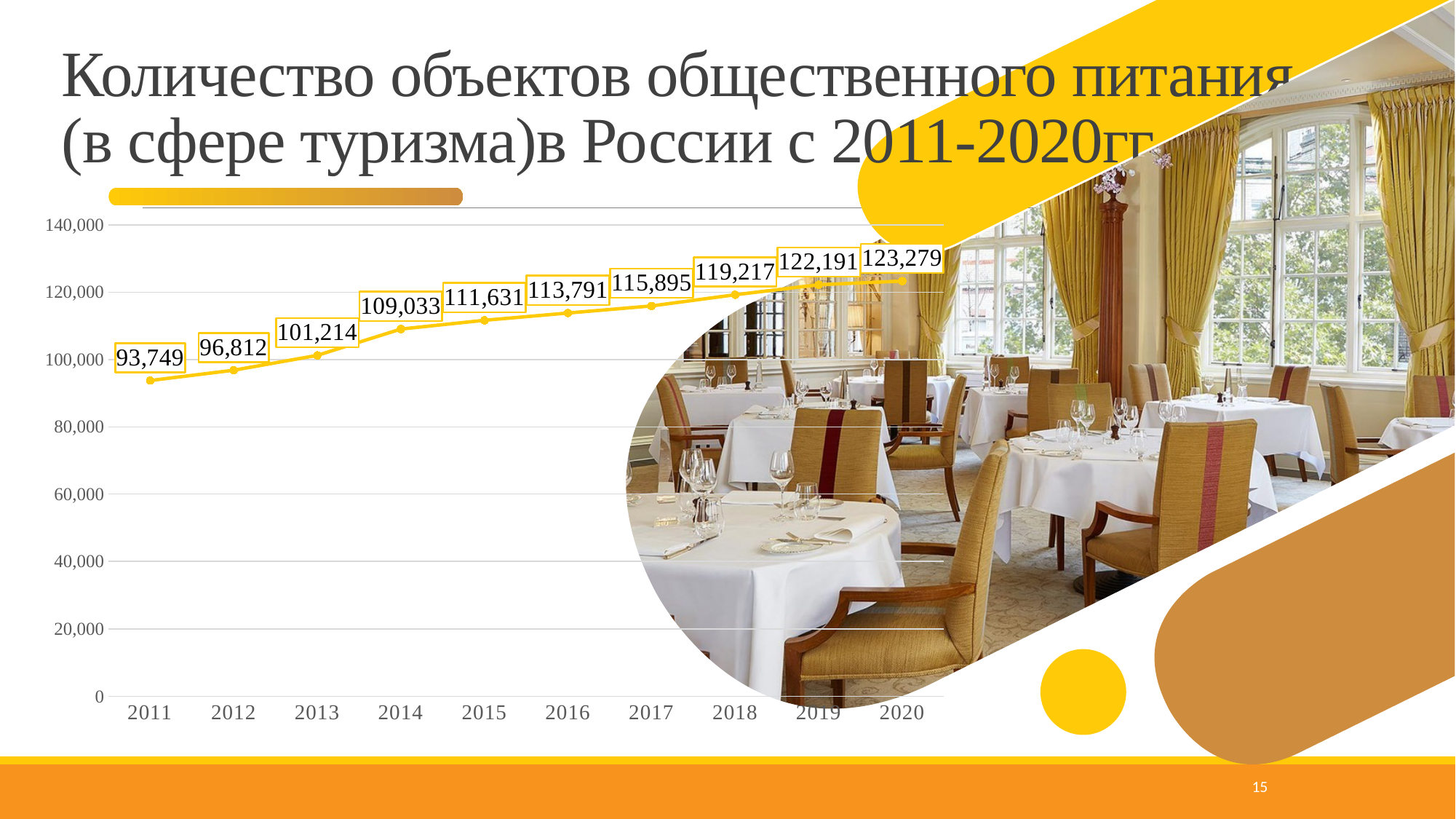
What is the value for 2018? 119,217 Which is larger, the value for 2016 or the value for 2017? 2017 What type of chart is shown on the slide? line chart What is the value for 2011? 93,749 What is the difference between the values for 2014 and 2013? 7,819 Do the values rise or fall from 2011 to 2020? rise How many years are plotted on the x axis? 10 What is the value for 2020? 123,279 What is the difference between the values for 2020 and 2011? 29,530 What is the value for 2014? 109,033 Which year has the lowest value? 2011 Which year has the highest value? 2020